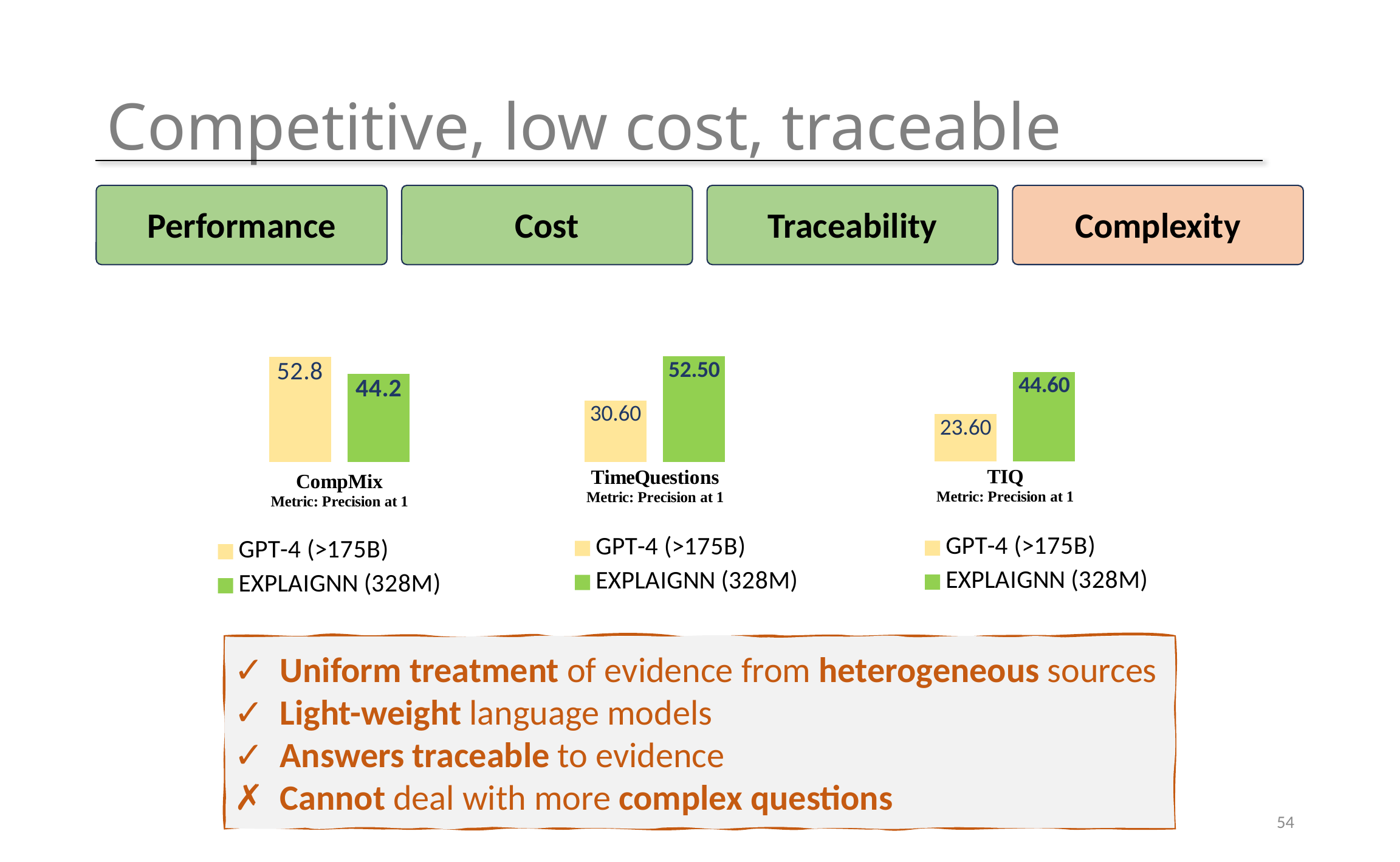
In the CompMix chart, which system has the higher value? GPT-4 (>175B) In the TimeQuestions chart, what is the value for EXPLAIGNN (328M)? 52.50 In the TIQ chart, which system has the lower value? GPT-4 (>175B) In the TimeQuestions chart, what is the value for GPT-4 (>175B)? 30.60 In the TIQ chart, what is the value for GPT-4 (>175B)? 23.60 In the TimeQuestions chart, what is the difference between the EXPLAIGNN (328M) value and the GPT-4 (>175B) value? 21.90 How many series does the legend of the TimeQuestions chart list? 2 In the CompMix chart, what is the value for EXPLAIGNN (328M)? 44.2 What type of chart is the CompMix chart? Bar chart In the CompMix chart, what is the value for GPT-4 (>175B)? 52.8 In the TIQ chart, what is the difference between the EXPLAIGNN (328M) value and the GPT-4 (>175B) value? 21.00 In the TIQ chart, what is the value for EXPLAIGNN (328M)? 44.60